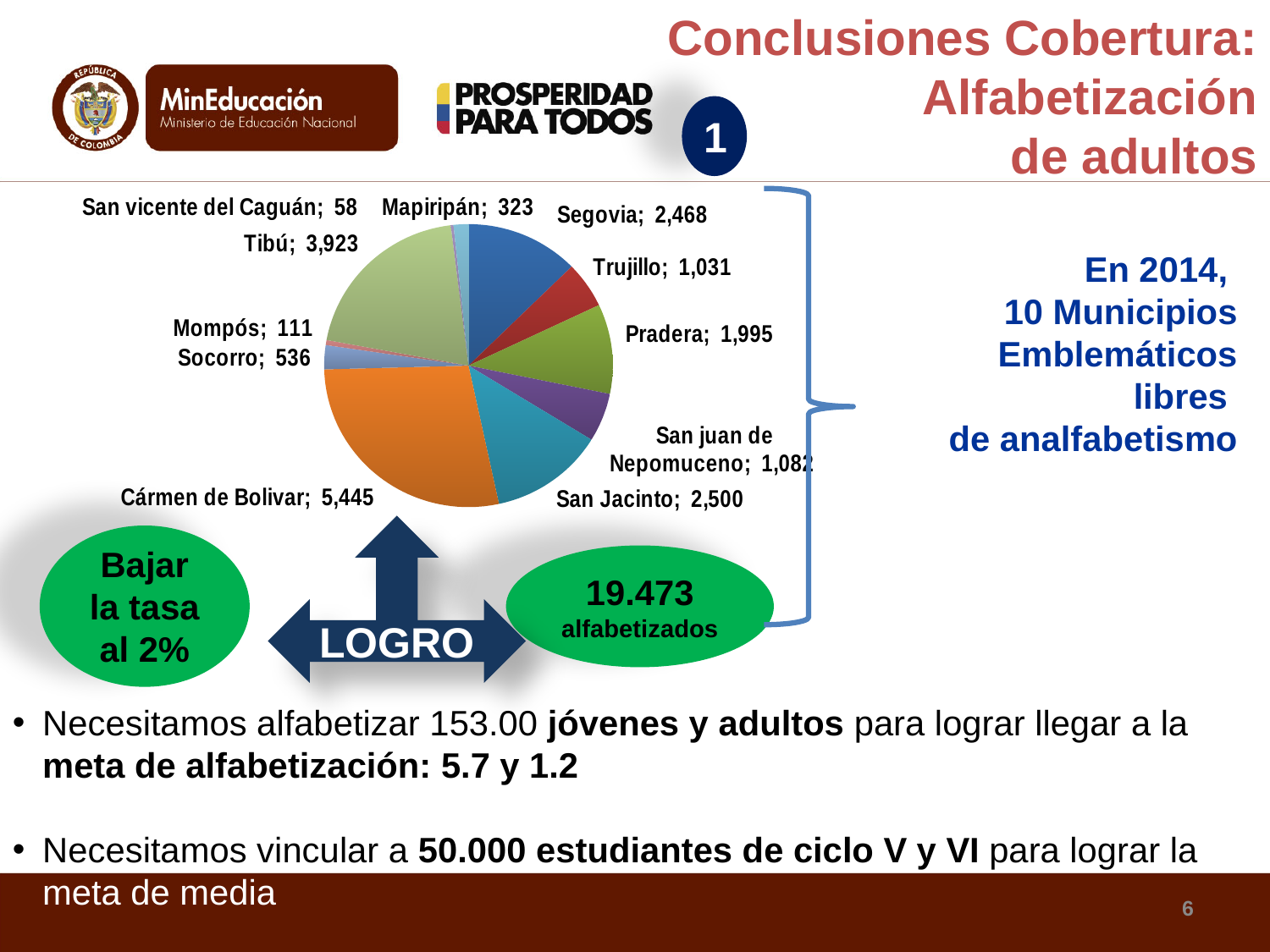
What is the value for Socorro in the pie chart? 536 Which municipality has the smallest slice in the pie chart? San vicente del Caguán What is the value for Mompós in the pie chart? 111 What is the value for Mapiripán in the pie chart? 323 What is the difference between the values for Tibú and Segovia? 1,455 What type of chart is shown on the slide? pie chart What is the value for Tibú in the pie chart? 3,923 How many municipalities are shown as slices in the pie chart? 11 Which municipality has the largest slice in the pie chart? Cármen de Bolivar Which is larger, the value for Trujillo or the value for Pradera? Pradera What is the value for Segovia in the pie chart? 2,468 What is the difference between the values for San Jacinto and Pradera? 505